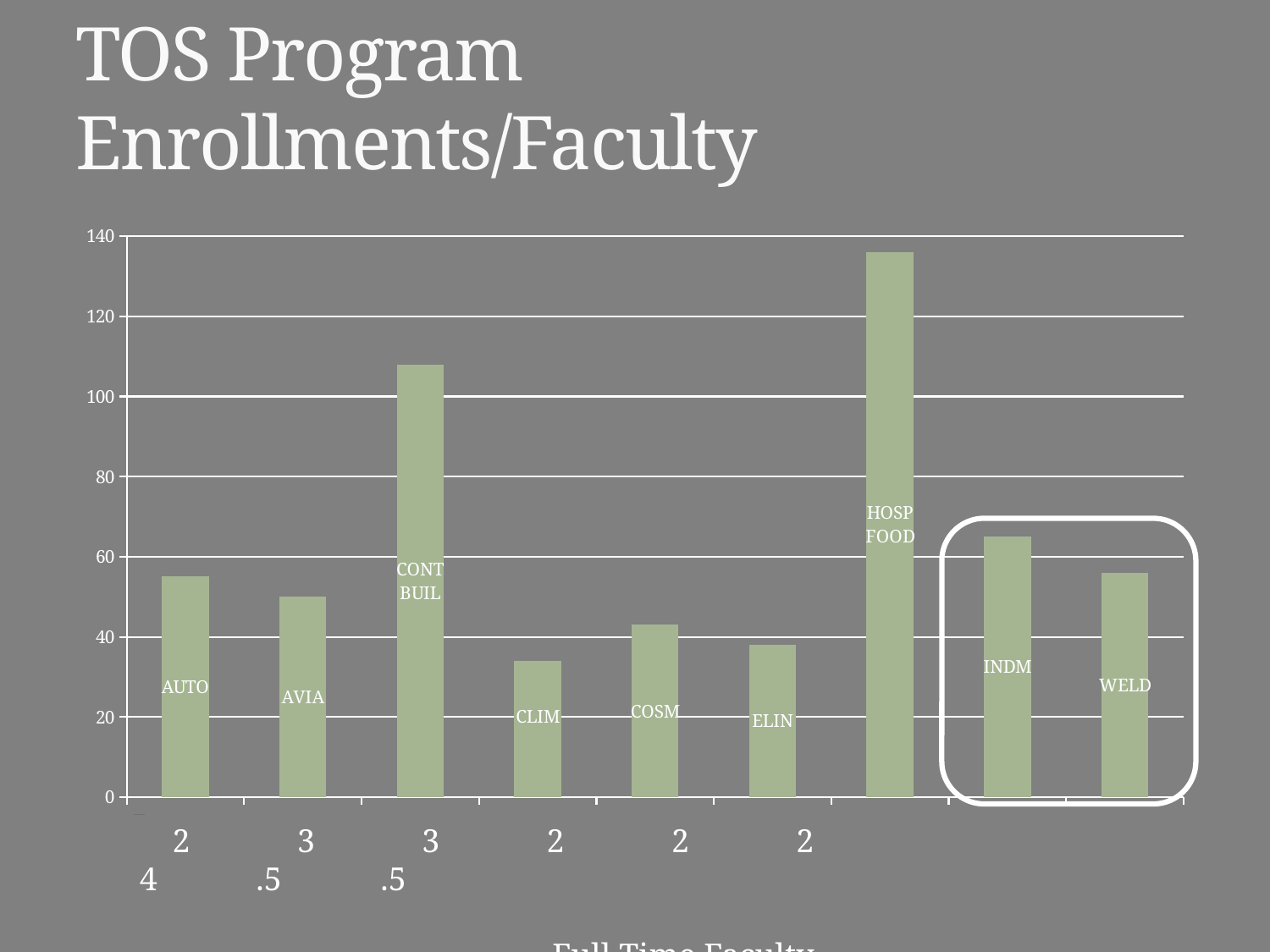
What is the title of the slide's chart? TOS Program Enrollments/Faculty Which program has the highest bar? HOSP FOOD Which is larger, the value for CONT BUIL or the value for INDM? CONT BUIL Is the value for INDM greater or less than 60? greater Which is larger, the value for INDM or the value for WELD? INDM How many bars (programs) are plotted in the chart? 9 Is the value for CONT BUIL greater or less than 100? greater Which two programs' bars are enclosed by the white rounded outline? INDM and WELD Is the value for AVIA greater or less than 60? less What kind of chart is shown on the slide? bar chart